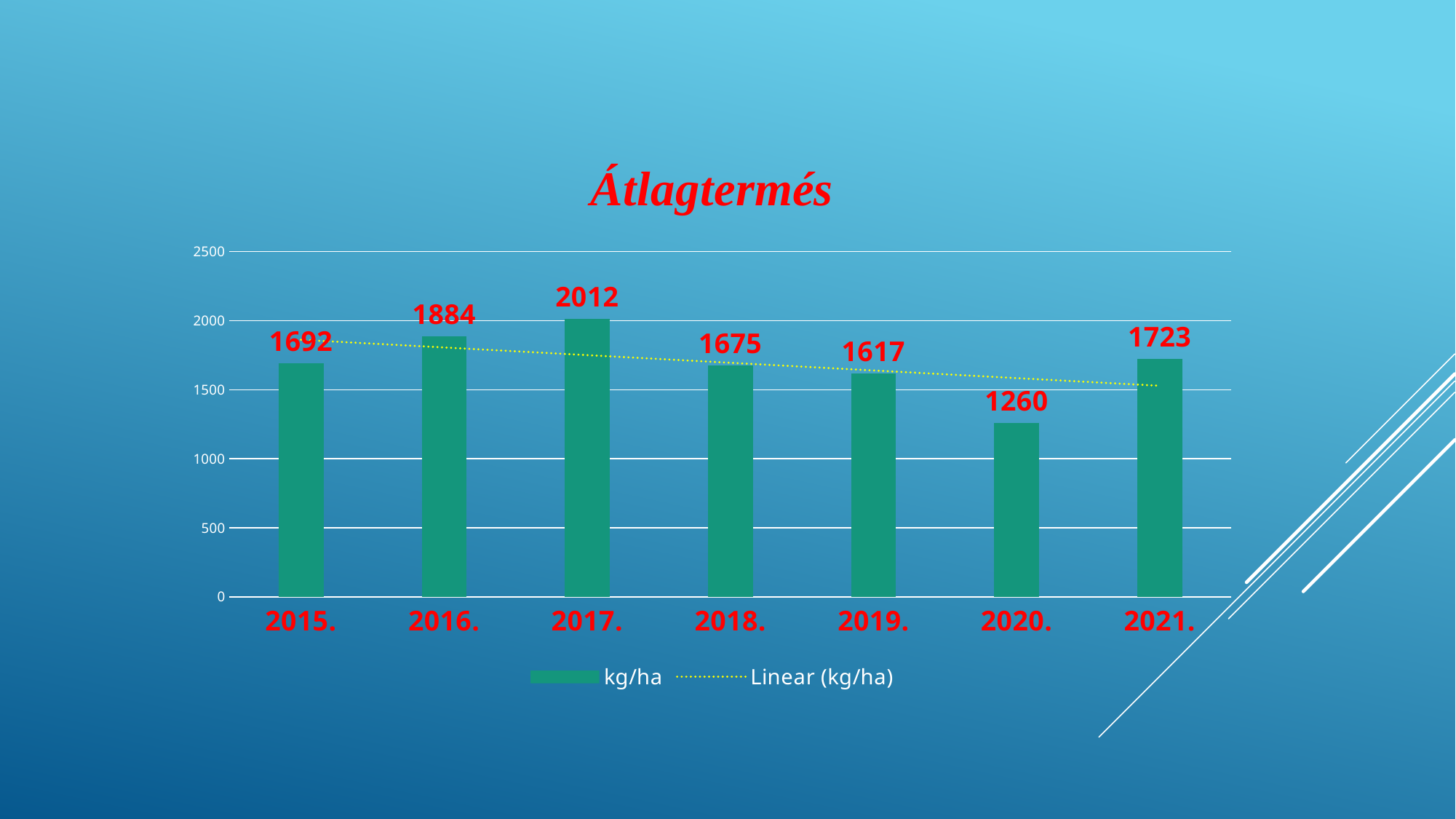
What is the value for 2017. in the Átlagtermés chart? 2012 Which year has the lowest value in the Átlagtermés chart? 2020. How many years are shown on the x axis of the chart? 7 What is the value for 2021. in the Átlagtermés chart? 1723 Which is larger, the value for 2018. or the value for 2019.? 2018. Which year has the highest value in the Átlagtermés chart? 2017. What is the difference between the values for 2017. and 2020.? 752 Is the value for 2016. greater or less than 2000? less What is the difference between the values for 2016. and 2015.? 192 What is the value for 2020. in the Átlagtermés chart? 1260 What kind of chart is shown on the slide? bar chart What is the title of the chart? Átlagtermés